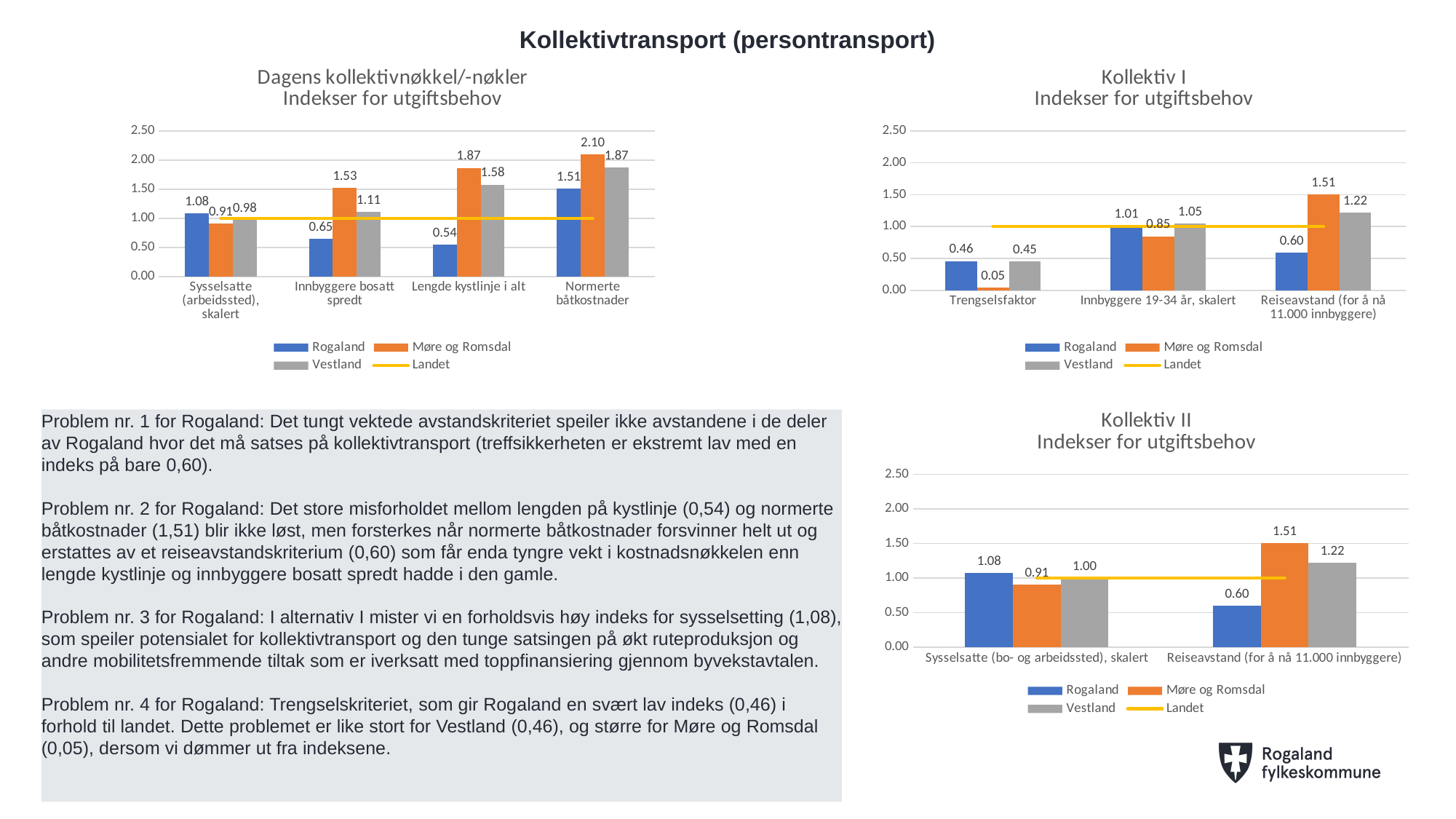
In the 'Kollektiv I' chart, is the Vestland value for 'Reiseavstand (for å nå 11.000 innbyggere)' larger or smaller than the Rogaland value? larger What kind of chart is the 'Kollektiv II' chart? combination bar and line chart In the 'Kollektiv I' chart, what is the value for Møre og Romsdal for 'Trengselsfaktor'? 0.05 In the 'Dagens kollektivnøkkel/-nøkler' chart, what is the value for Møre og Romsdal for 'Normerte båtkostnader'? 2.10 In the 'Kollektiv II' chart, what is the difference between the Møre og Romsdal and Vestland values for 'Reiseavstand (for å nå 11.000 innbyggere)'? 0.29 In the 'Dagens kollektivnøkkel/-nøkler' chart, what is the difference between the Møre og Romsdal and Rogaland values for 'Innbyggere bosatt spredt'? 0.88 In the 'Dagens kollektivnøkkel/-nøkler' chart, how many categories are shown on the x axis? 4 In the 'Dagens kollektivnøkkel/-nøkler' chart, what is the value for Rogaland for 'Lengde kystlinje i alt'? 0.54 In the 'Kollektiv II' chart, what is the value for Vestland for 'Sysselsatte (bo- og arbeidssted), skalert'? 1.00 In the 'Dagens kollektivnøkkel/-nøkler' chart, which category has the highest value for Rogaland? Normerte båtkostnader In the 'Kollektiv I' chart, which category has the lowest value for Rogaland? Trengselsfaktor In the 'Kollektiv I' chart, how many series does the legend list? 4